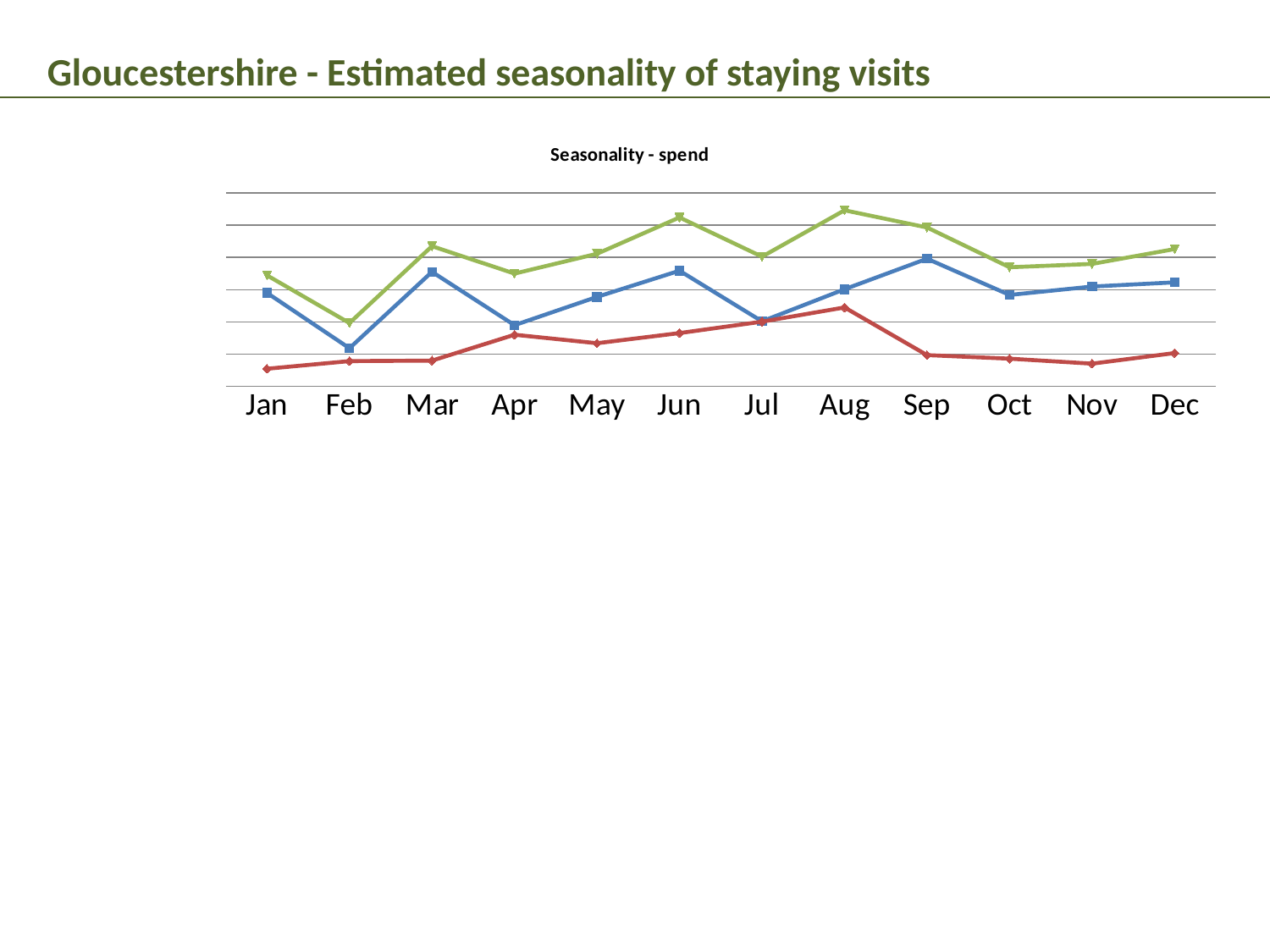
In which month does the red line reach its highest point? Aug In which month does the green line reach its lowest point? Feb In which month does the blue line reach its lowest point? Feb How many months are shown on the x axis of the chart? 12 In which month does the red line reach its lowest point? Jan In which month does the green line reach its highest point? Aug What is the title of the chart? Seasonality - spend Does the red line rise or fall from Aug to Sep? fall How many lines are plotted on the chart? 3 What kind of chart is shown on the slide? line chart Does the green line rise or fall from Jan to Feb? fall In Aug, which line is higher, the green line or the blue line? green